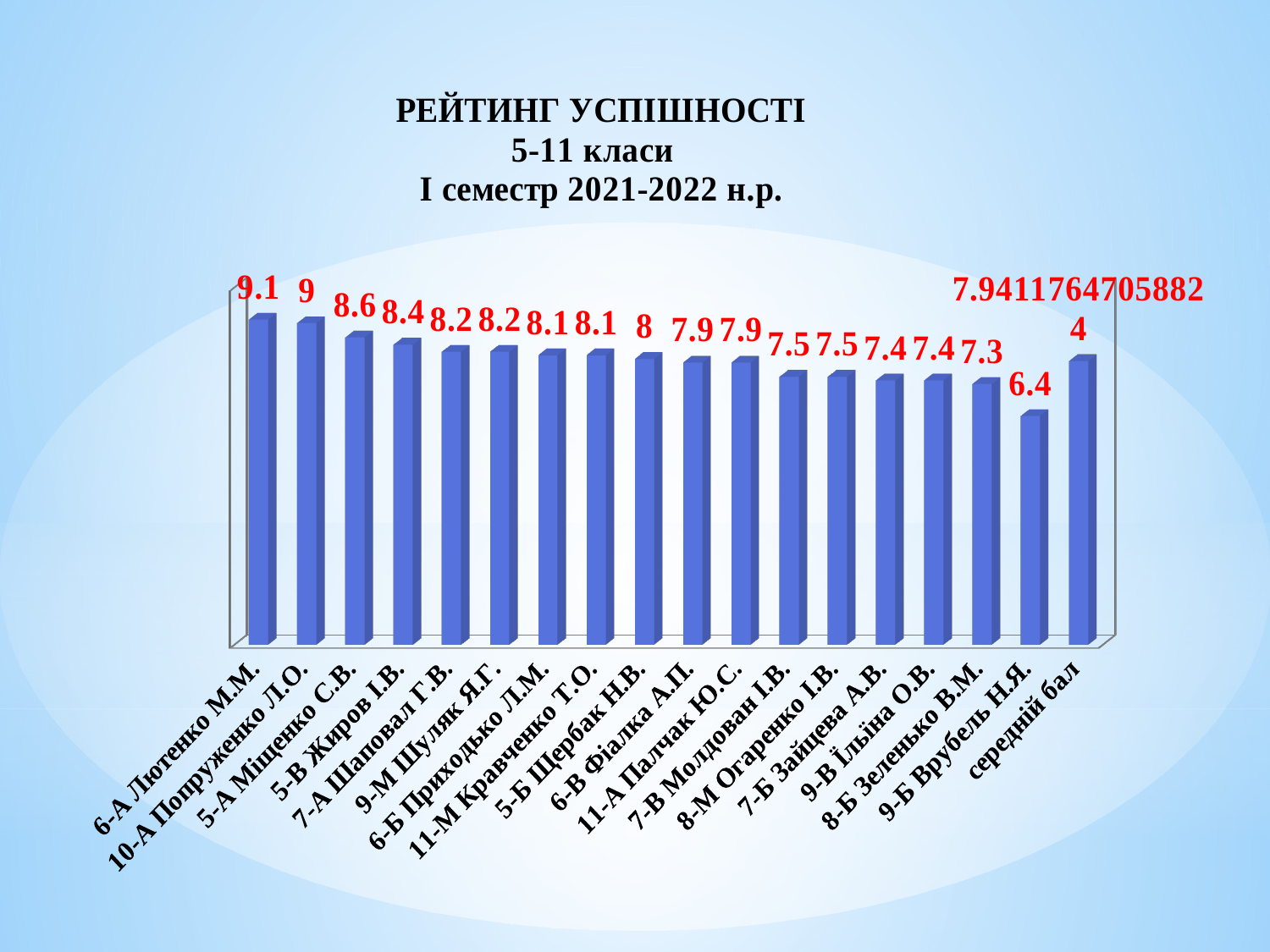
What is the difference between the values for 6-А Лютенко М.М. and 9-Б Врубель Н.Я.? 2.7 What is the value for 8-Б Зеленько В.М.? 7.3 Which category has the highest value? 6-А Лютенко М.М. What type of chart is shown on the slide? bar chart Which is larger, the value for 5-А Міщенко С.В. or the value for 7-А Шаповал Г.В.? 5-А Міщенко С.В. How many bars are plotted in the chart? 18 What is the value for 6-А Лютенко М.М.? 9.1 What is the value for 5-А Міщенко С.В.? 8.6 Do the class values rise or fall from left to right across the chart (before the final average bar)? fall What is the value for 9-Б Врубель Н.Я.? 6.4 What is the value shown for середній бал? 7.94117647058824 Which category has the lowest value? 9-Б Врубель Н.Я.